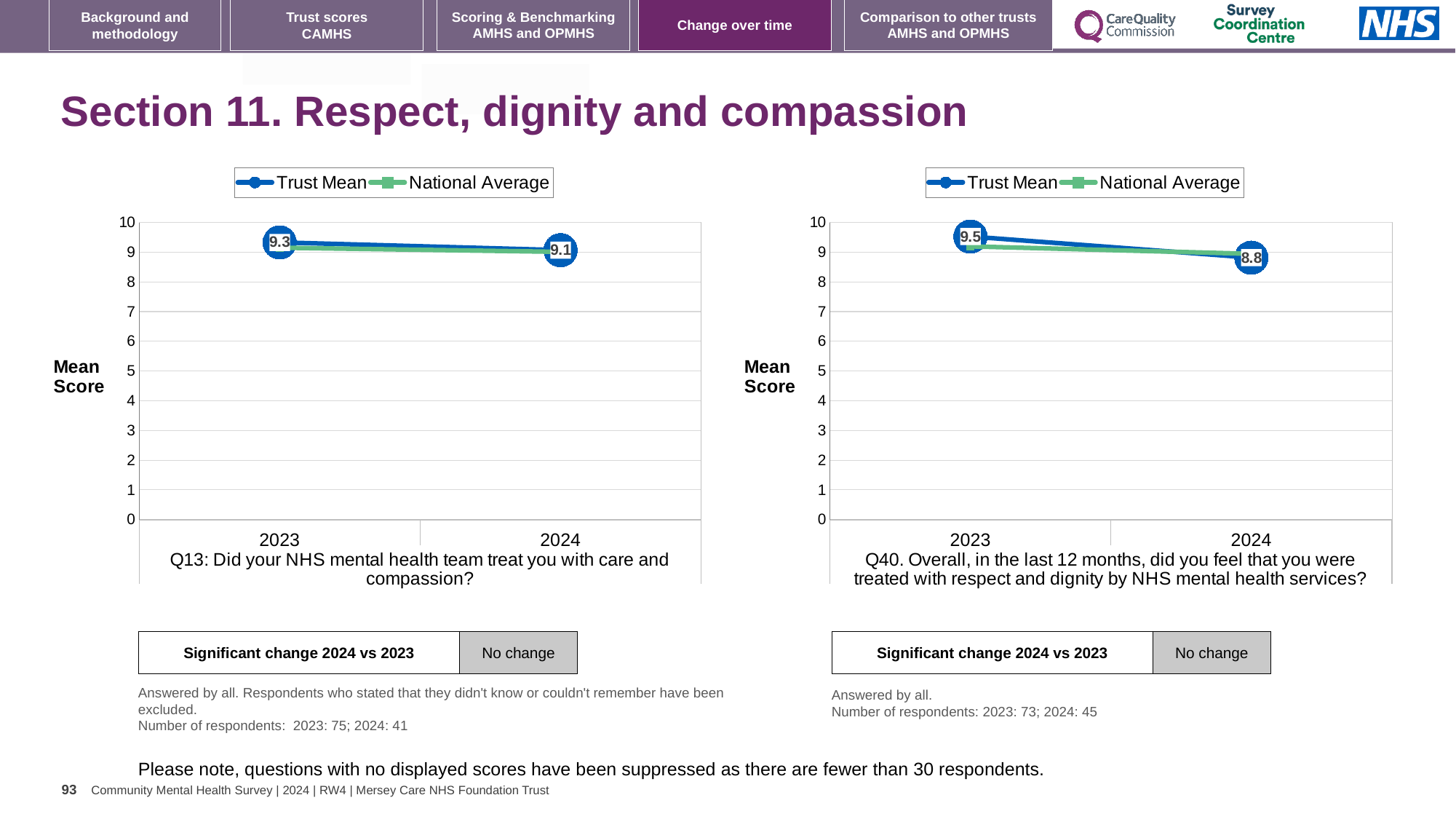
In the right chart (Q40), does the Trust Mean rise or fall from 2023 to 2024? fall Which year has the higher Trust Mean in the right chart (Q40), 2023 or 2024? 2023 In the right chart (Q40), what is the Trust Mean score for 2024? 8.8 How many series does the legend of the right chart (Q40) list? 2 In the left chart (Q13), what is the Trust Mean score for 2023? 9.3 What type of chart is the left chart (Q13)? line chart In the right chart (Q40), what is the Trust Mean score for 2023? 9.5 In the right chart (Q40), by how much did the Trust Mean fall from 2023 to 2024? 0.7 In the left chart (Q13), what is the Trust Mean score for 2024? 9.1 In the right chart (Q40), is the National Average value for 2023 greater or less than 8? greater How many years are shown on the x axis of the left chart (Q13)? 2 In the left chart (Q13), what is the difference between the Trust Mean in 2023 and 2024? 0.2